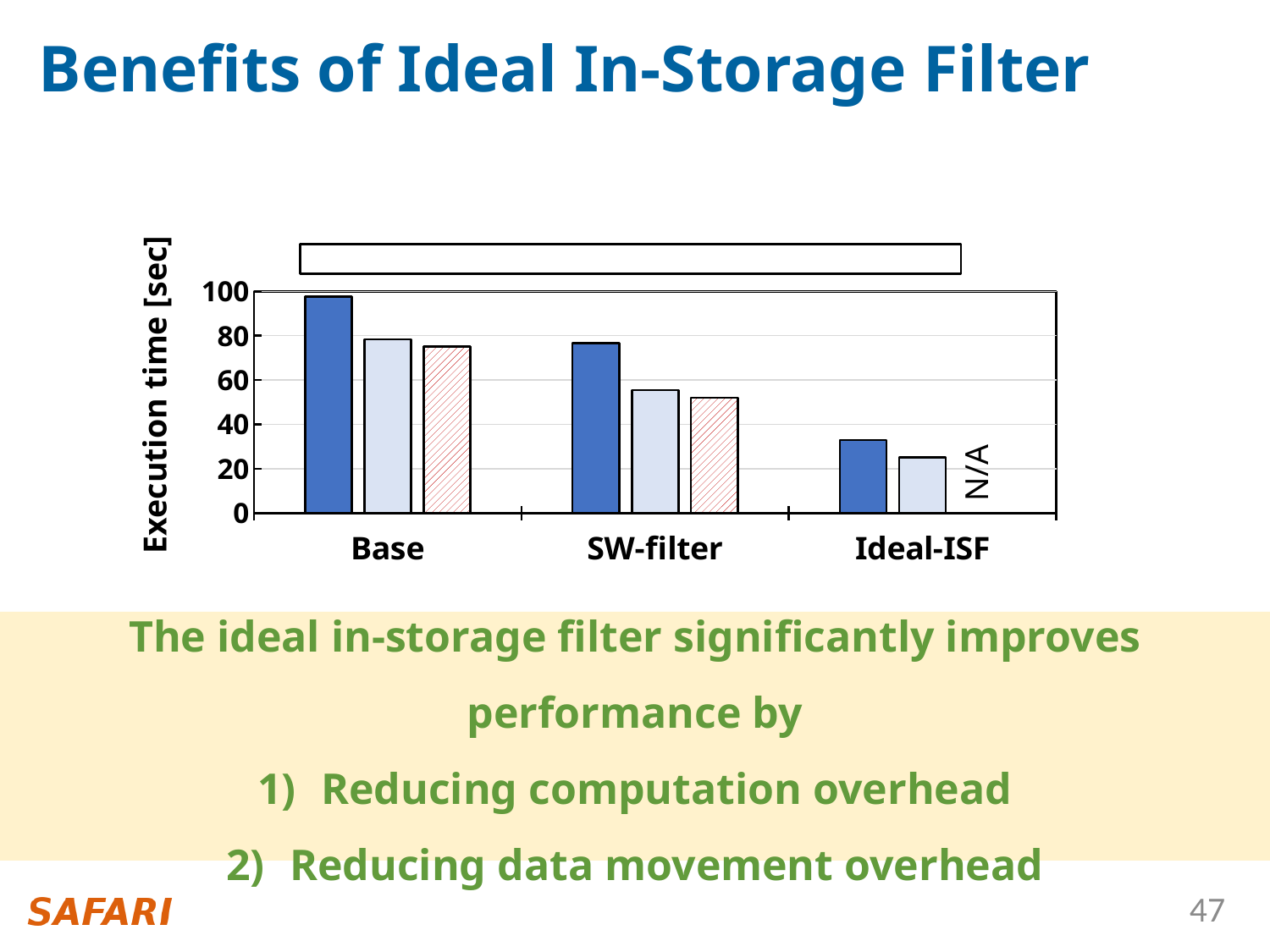
Which category has the tallest dark blue bar? Base Is the dark blue bar for Base greater or less than 80? greater What is shown in place of the red hatched bar for Ideal-ISF? N/A Is the dark blue bar for Ideal-ISF greater or less than 40? less What is the label of the y axis of the chart? Execution time [sec] Which category has the shortest dark blue bar? Ideal-ISF Is the red hatched bar for Base greater or less than 60? greater Which is larger, the dark blue bar for SW-filter or the dark blue bar for Ideal-ISF? SW-filter What type of chart is shown on the slide? bar chart How many categories are shown on the x axis of the chart? 3 Do the dark blue bars rise or fall from Base to Ideal-ISF along the x axis? fall